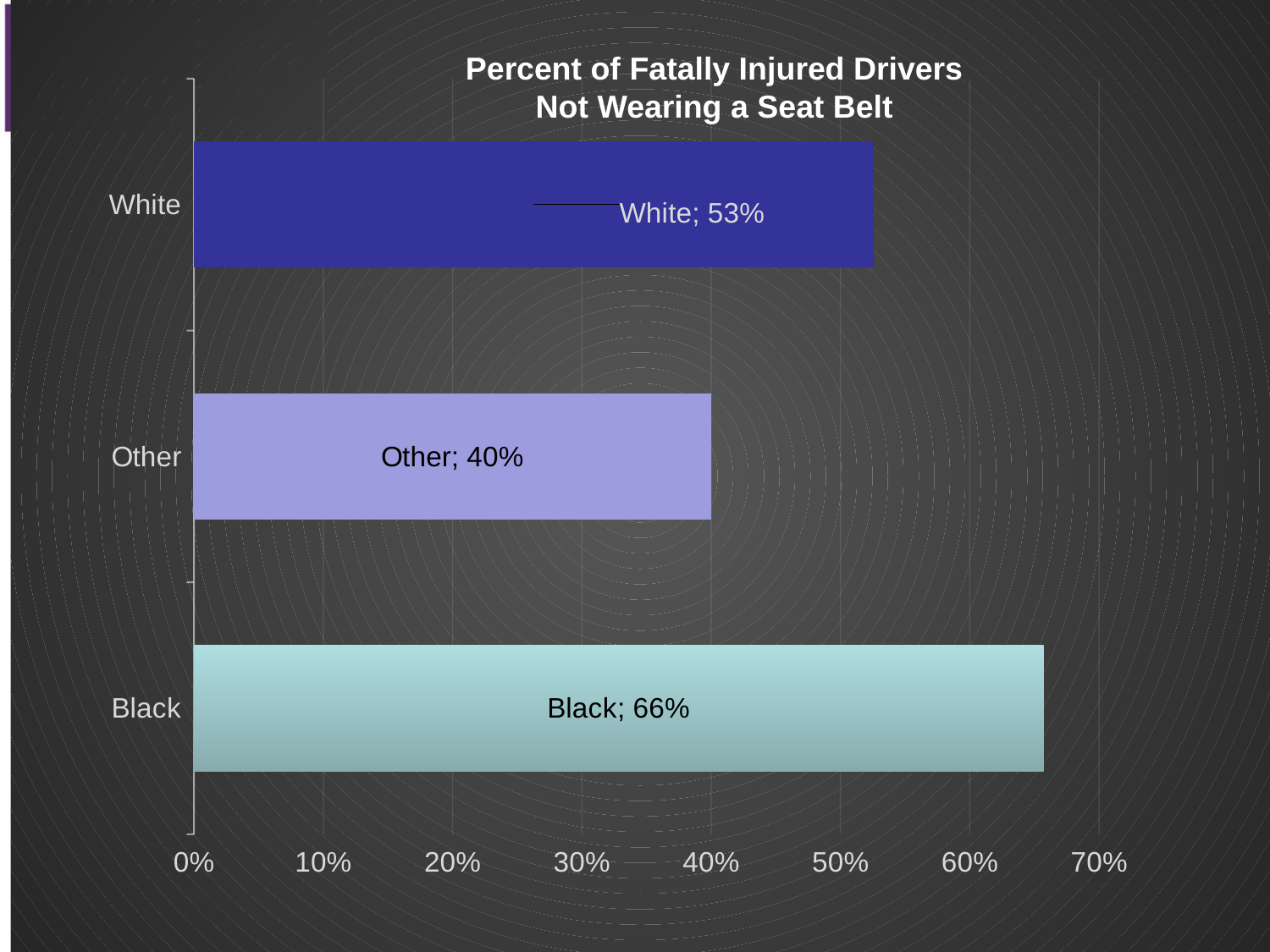
What kind of chart is shown on the slide? Bar chart Which category has the highest percentage of fatally injured drivers not wearing a seat belt? Black What is the difference between the values for Black and White? 13% Which category has the lowest percentage of fatally injured drivers not wearing a seat belt? Other What is the title of the chart? Percent of Fatally Injured Drivers Not Wearing a Seat Belt Is the value for Black greater or less than 60%? greater What is the value for Black? 66% What is the value for White? 53% What is the value for Other? 40% What is the difference between the values for White and Other? 13% How many categories are shown in the chart? 3 Which is larger, the value for White or the value for Other? White